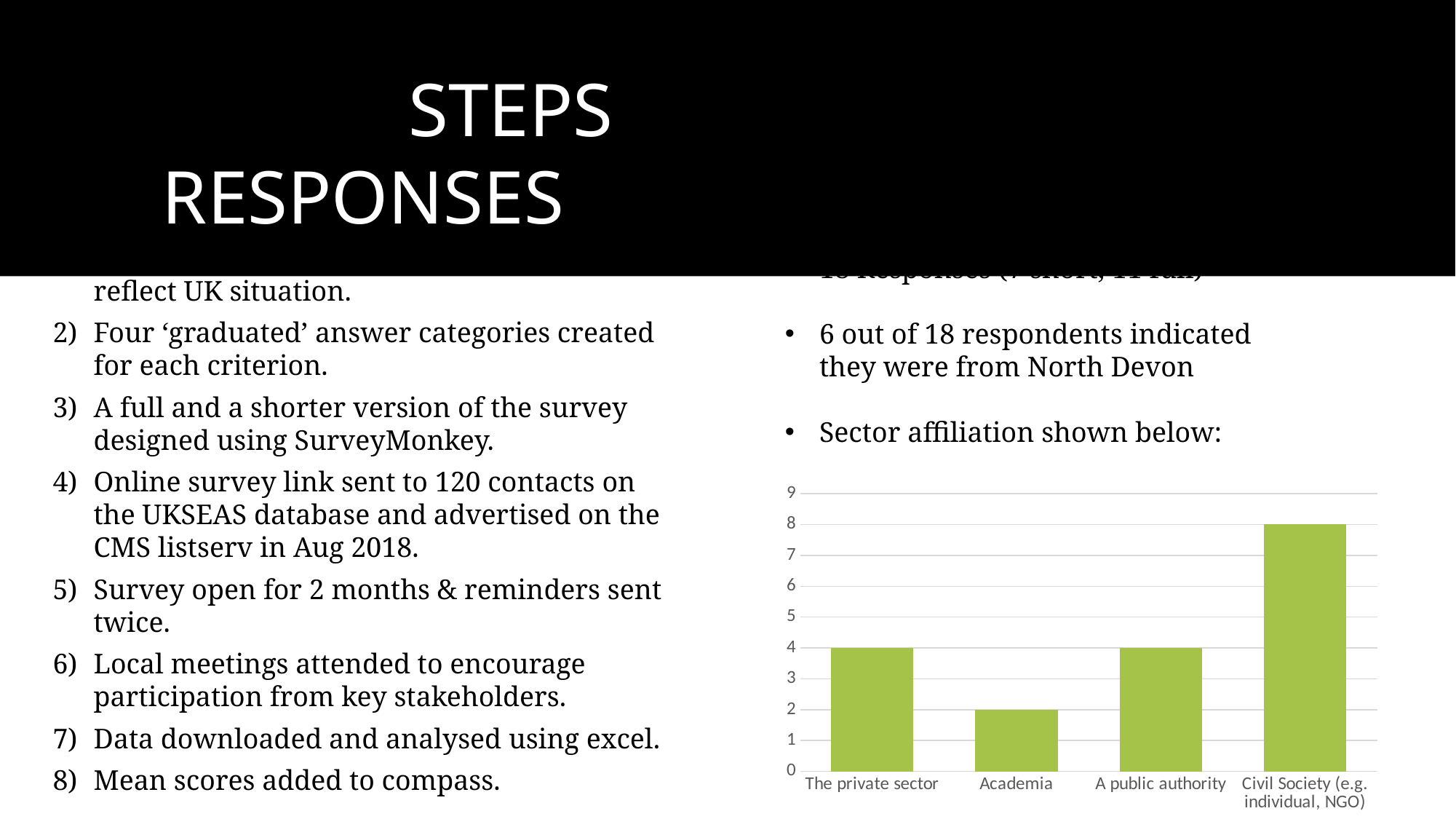
How many categories are shown on the x axis of the chart? 4 Is the value for Civil Society (e.g. individual, NGO) greater or less than 5? greater What is the value for Academia in the chart? 2 What is the difference between the values for Civil Society (e.g. individual, NGO) and Academia? 6 Which category has the lowest value in the chart? Academia What is the value for The private sector in the chart? 4 What is the highest value shown on the chart's vertical axis? 9 What is the value for A public authority in the chart? 4 Which is larger, the value for Academia or the value for A public authority? A public authority What is the value for Civil Society (e.g. individual, NGO) in the chart? 8 Which category has the highest value in the chart? Civil Society (e.g. individual, NGO) What kind of chart is shown on the slide? bar chart